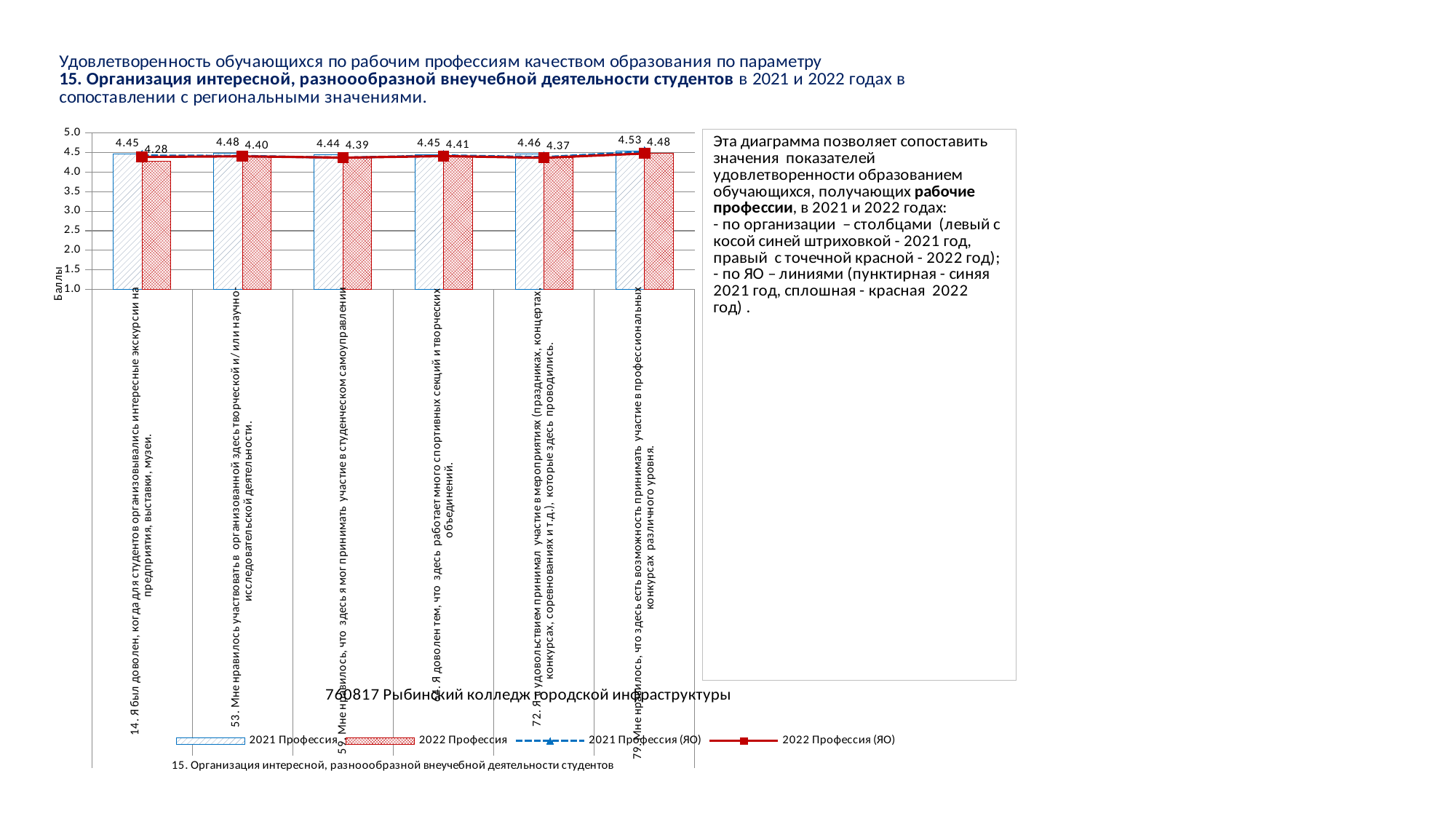
What kind of chart is shown on the slide? A combined bar and line chart What is the 2021 Профессия value for item 72 (участие в мероприятиях: праздниках, концертах, конкурсах)? 4.46 How many series does the chart legend list? 4 Which survey item has the lowest 2022 Профессия value? 14. Я был доволен, когда для студентов организовывались интересные экскурсии на предприятия, выставки, музеи. What is the 2022 Профессия value for item 79 (участие в профессиональных конкурсах различного уровня)? 4.48 What is the 2022 Профессия value for item 14 (экскурсии на предприятия, выставки, музеи)? 4.28 Which survey item has the highest 2021 Профессия value? 79. Мне нравилось, что здесь есть возможность принимать участие в профессиональных конкурсах различного уровня. What is the 2021 Профессия value for item 14 (экскурсии на предприятия, выставки, музеи)? 4.45 For item 53, which is larger: the 2021 Профессия value or the 2022 Профессия value? 2021 Профессия (4.48) What is the difference between the 2021 Профессия and 2022 Профессия values for item 14? 0.17 How many categories (survey items) are plotted along the x axis? 6 What label is shown on the vertical axis of the chart? Баллы